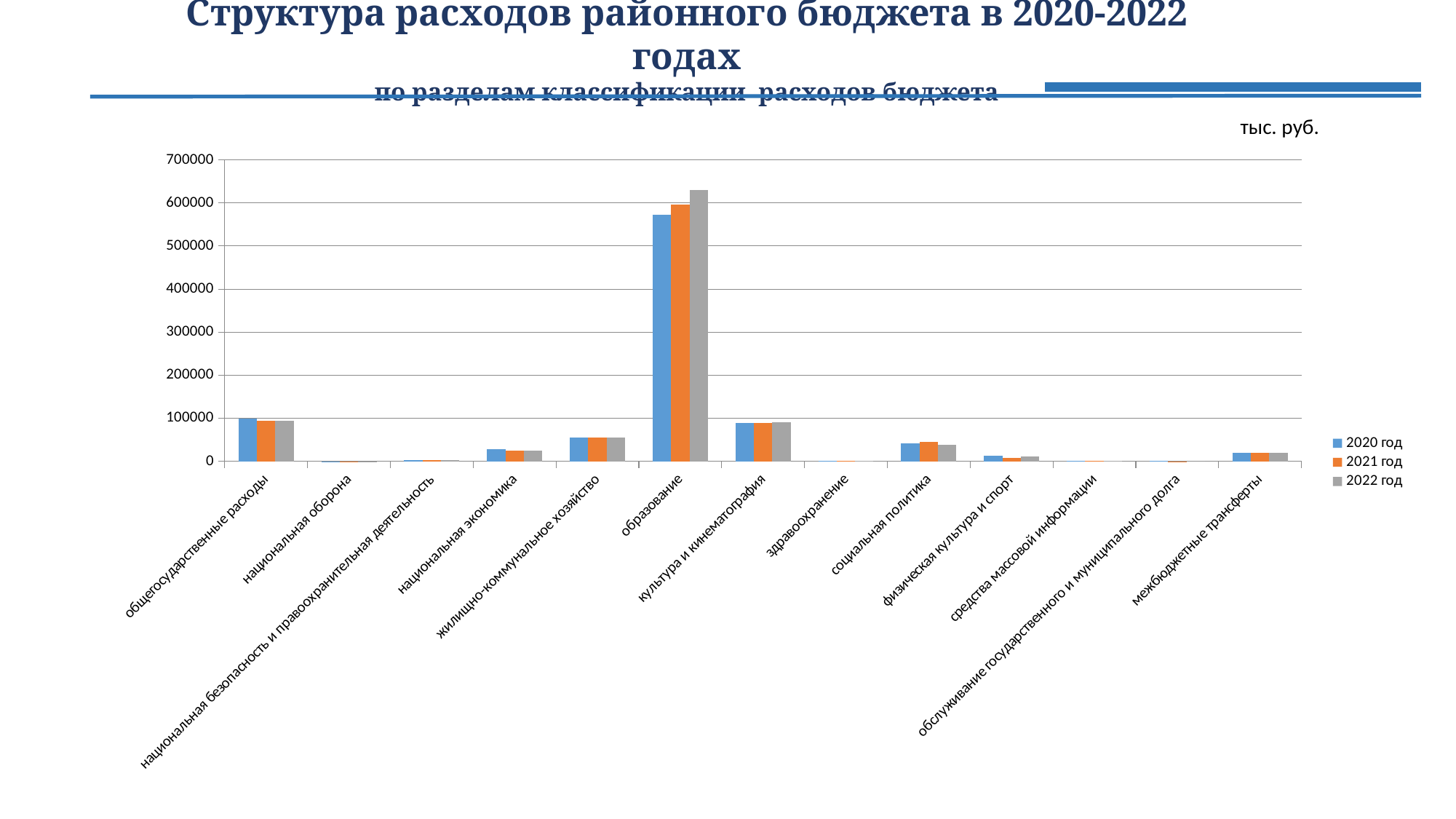
How many series does the legend list? 3 What kind of chart is shown on the slide? bar chart How many expenditure categories are shown on the x axis? 13 Do the values for образование rise or fall from 2020 год to 2022 год? rise What unit is indicated above the chart? тыс. руб. Which category has the highest values in the chart? образование Is the value for образование in 2022 год greater or less than 600000? greater Is the value for жилищно-коммунальное хозяйство in 2021 год greater or less than 100000? less Is the value for образование in 2020 год greater or less than 600000? less Which is larger for образование: the value for 2020 год or the value for 2022 год? 2022 год Which is larger in 2020 год: культура и кинематография or социальная политика? культура и кинематография